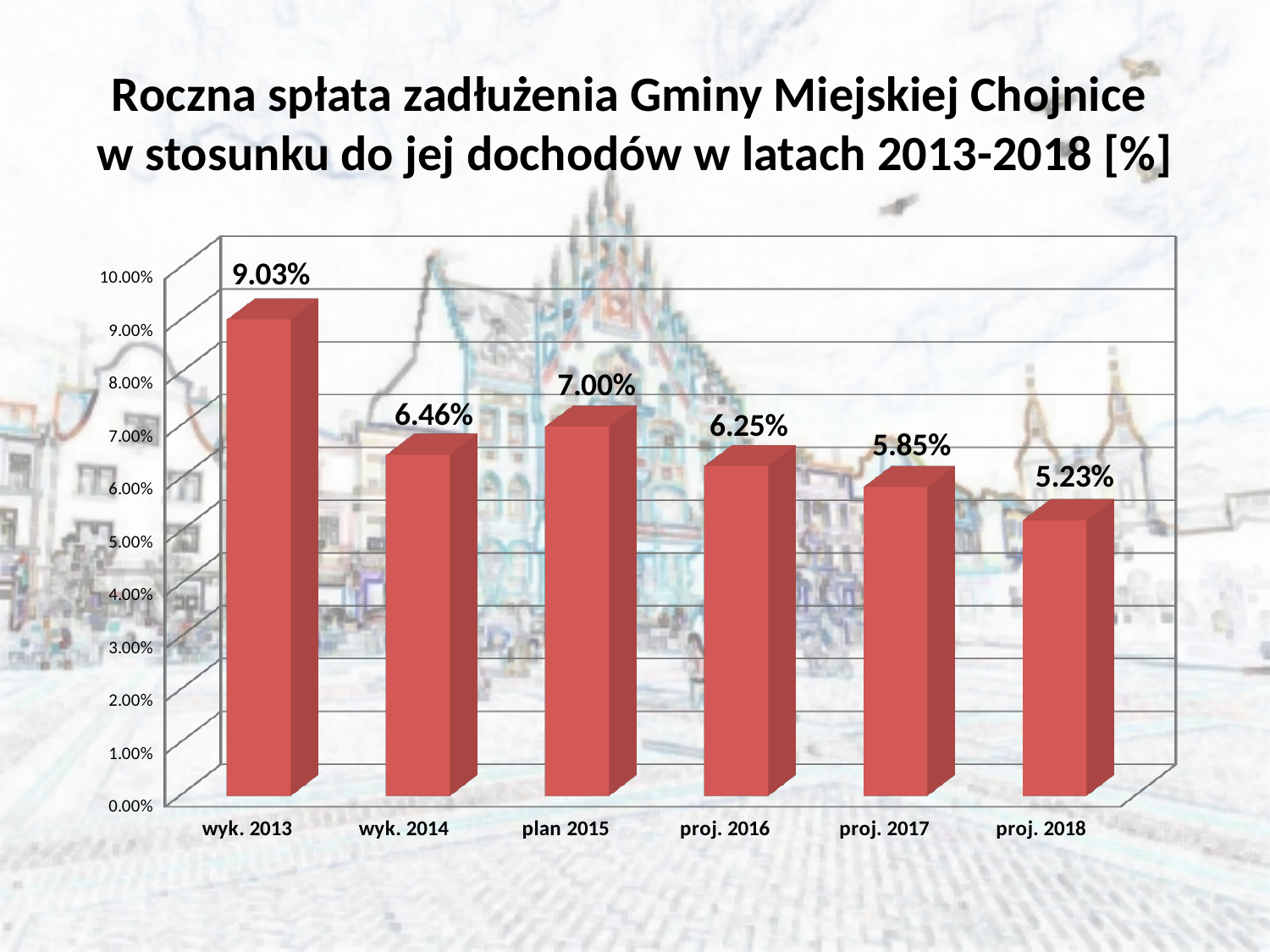
What is the value for proj. 2018? 5.23% Is the value for proj. 2017 greater or less than 6.00%? less Which is larger, the value for plan 2015 or the value for proj. 2017? plan 2015 What is the value for plan 2015? 7.00% Which category has the highest value? wyk. 2013 What is the value for wyk. 2013? 9.03% Do the values generally rise or fall from wyk. 2013 to proj. 2018? fall What kind of chart is shown on the slide? bar chart How many categories are shown on the x axis? 6 What is the difference between the values for wyk. 2013 and wyk. 2014? 2.57% What is the value for proj. 2016? 6.25% Which category has the lowest value? proj. 2018